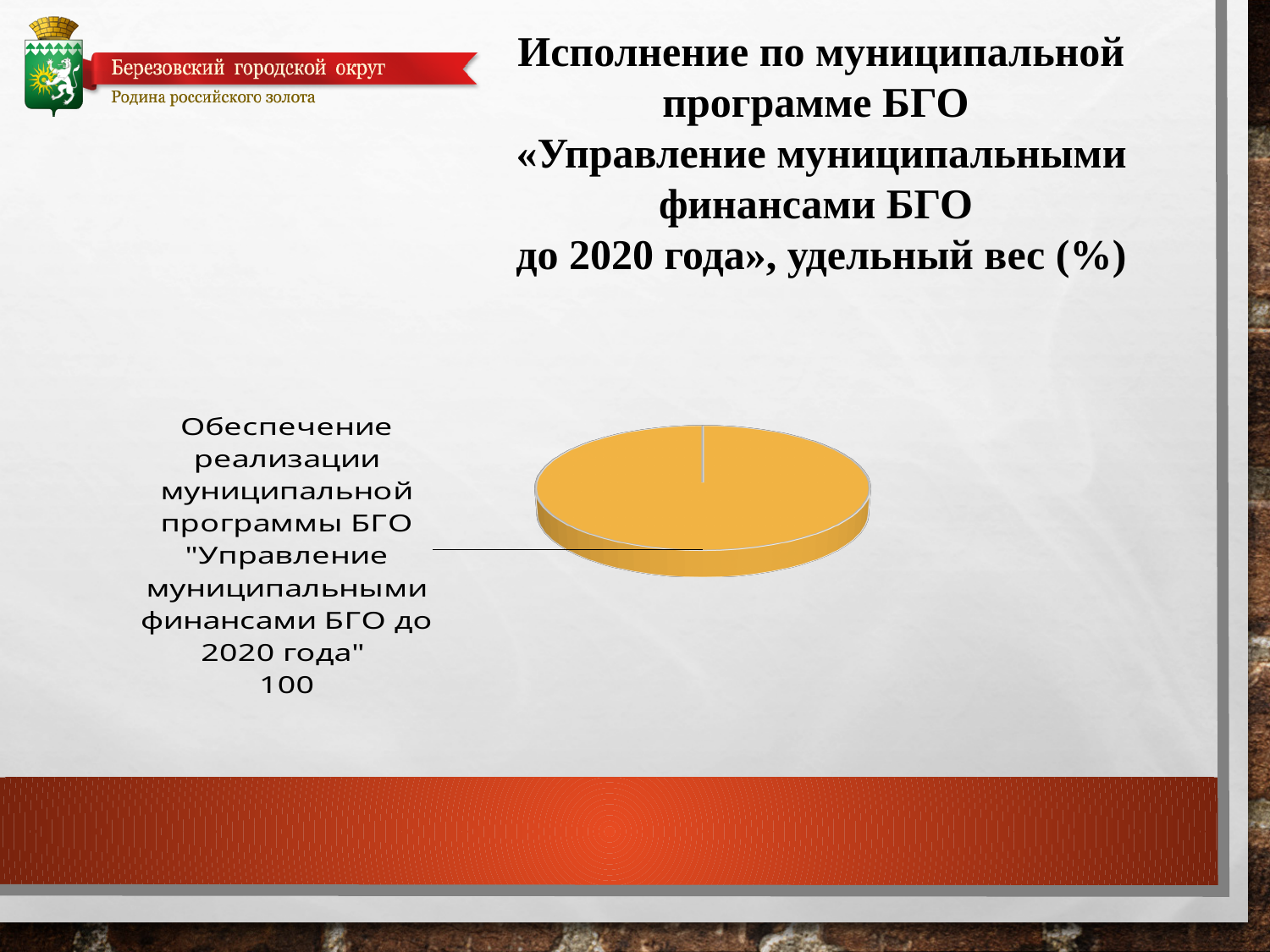
Which category is the largest in the pie chart? Обеспечение реализации муниципальной программы БГО "Управление муниципальными финансами БГО до 2020 года" What kind of chart is shown on the slide? Pie chart How many slices does the pie chart have? 1 What colour is the pie chart slice? Orange/yellow What value is shown for the slice "Обеспечение реализации муниципальной программы БГО "Управление муниципальными финансами БГО до 2020 года""? 100 What share of the pie does the slice "Обеспечение реализации муниципальной программы БГО "Управление муниципальными финансами БГО до 2020 года"" represent? 100% According to the slide title, in what unit are the values of the chart expressed? Удельный вес (%)